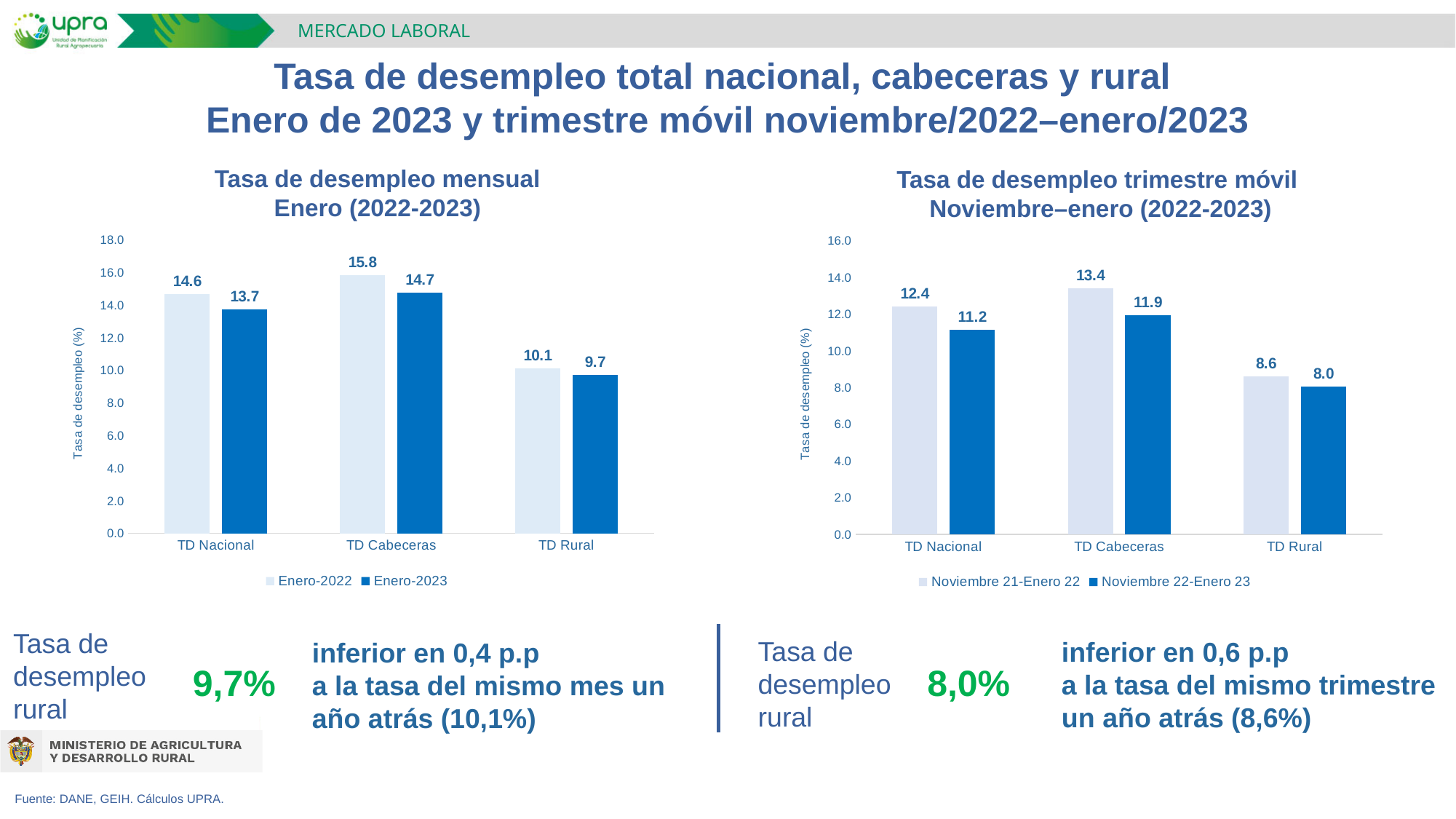
In the left chart (Tasa de desempleo mensual Enero), what is the value for TD Cabeceras in Enero-2022? 15.8 In the right chart (Tasa de desempleo trimestre móvil), what is the value for TD Rural in Noviembre 22-Enero 23? 8.0 In the right chart (Tasa de desempleo trimestre móvil), what is the difference between the Noviembre 21-Enero 22 and Noviembre 22-Enero 23 values for TD Cabeceras? 1.5 What is the y-axis label of the right chart (Tasa de desempleo trimestre móvil)? Tasa de desempleo (%) In the right chart (Tasa de desempleo trimestre móvil), which category has the highest value for Noviembre 21-Enero 22? TD Cabeceras What kind of chart is the left chart (Tasa de desempleo mensual Enero)? Bar chart How many categories are shown on the x axis of the left chart (Tasa de desempleo mensual Enero)? 3 In the left chart (Tasa de desempleo mensual Enero), what is the value for TD Nacional in Enero-2023? 13.7 In the left chart (Tasa de desempleo mensual Enero), which category has the lowest value for Enero-2023? TD Rural In the left chart (Tasa de desempleo mensual Enero), what is the difference between the Enero-2022 and Enero-2023 values for TD Rural? 0.4 How many series does the legend of the right chart (Tasa de desempleo trimestre móvil) list? 2 In the right chart (Tasa de desempleo trimestre móvil), which is larger for TD Nacional: Noviembre 21-Enero 22 or Noviembre 22-Enero 23? Noviembre 21-Enero 22